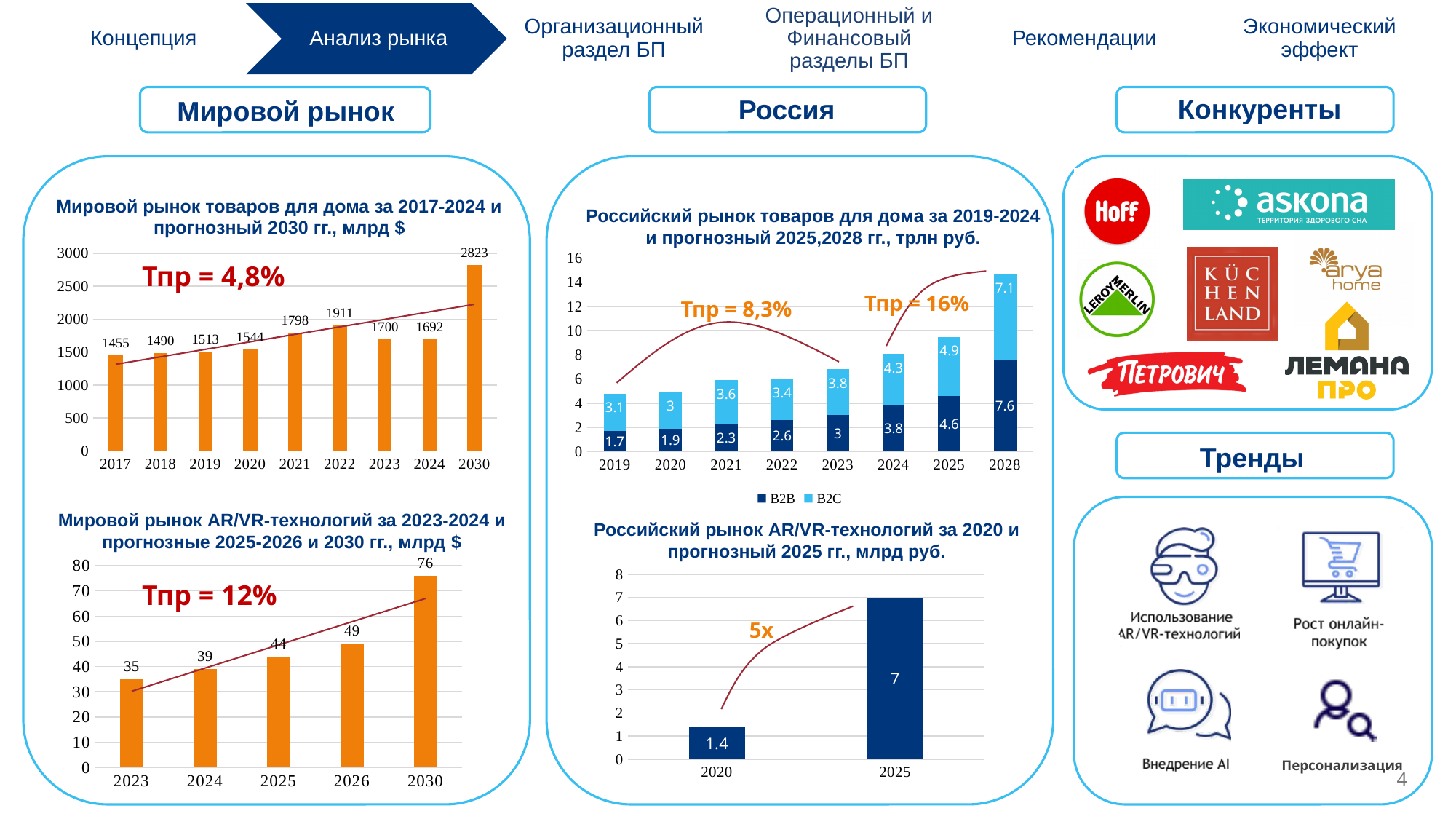
In the chart 'Мировой рынок товаров для дома за 2017-2024 и прогнозный 2030 гг., млрд $', what is the value for 2022? 1911 In the chart 'Российский рынок товаров для дома за 2019-2024 и прогнозный 2025,2028 гг., трлн руб.', what is the total of the stacked bar for 2028? 14.7 What type of chart is 'Российский рынок AR/VR-технологий за 2020 и прогнозный 2025 гг., млрд руб.'? bar chart In the chart 'Мировой рынок AR/VR-технологий за 2023-2024 и прогнозные 2025-2026 и 2030 гг., млрд $', what is the value for 2026? 49 In the chart 'Мировой рынок AR/VR-технологий за 2023-2024 и прогнозные 2025-2026 и 2030 гг., млрд $', what is the difference between the values for 2030 and 2023? 41 In the chart 'Мировой рынок товаров для дома за 2017-2024 и прогнозный 2030 гг., млрд $', how many bars are plotted? 9 In the chart 'Мировой рынок AR/VR-технологий за 2023-2024 и прогнозные 2025-2026 и 2030 гг., млрд $', do the values rise or fall from 2023 to 2030? rise In the chart 'Российский рынок AR/VR-технологий за 2020 и прогнозный 2025 гг., млрд руб.', what is the value for 2020? 1.4 In the chart 'Российский рынок товаров для дома за 2019-2024 и прогнозный 2025,2028 гг., трлн руб.', how many series does the legend list? 2 In the chart 'Мировой рынок товаров для дома за 2017-2024 и прогнозный 2030 гг., млрд $', which year has the lowest value? 2017 In the chart 'Мировой рынок товаров для дома за 2017-2024 и прогнозный 2030 гг., млрд $', which year has the highest value? 2030 In the chart 'Российский рынок товаров для дома за 2019-2024 и прогнозный 2025,2028 гг., трлн руб.', what is the B2B value for 2024? 3.8